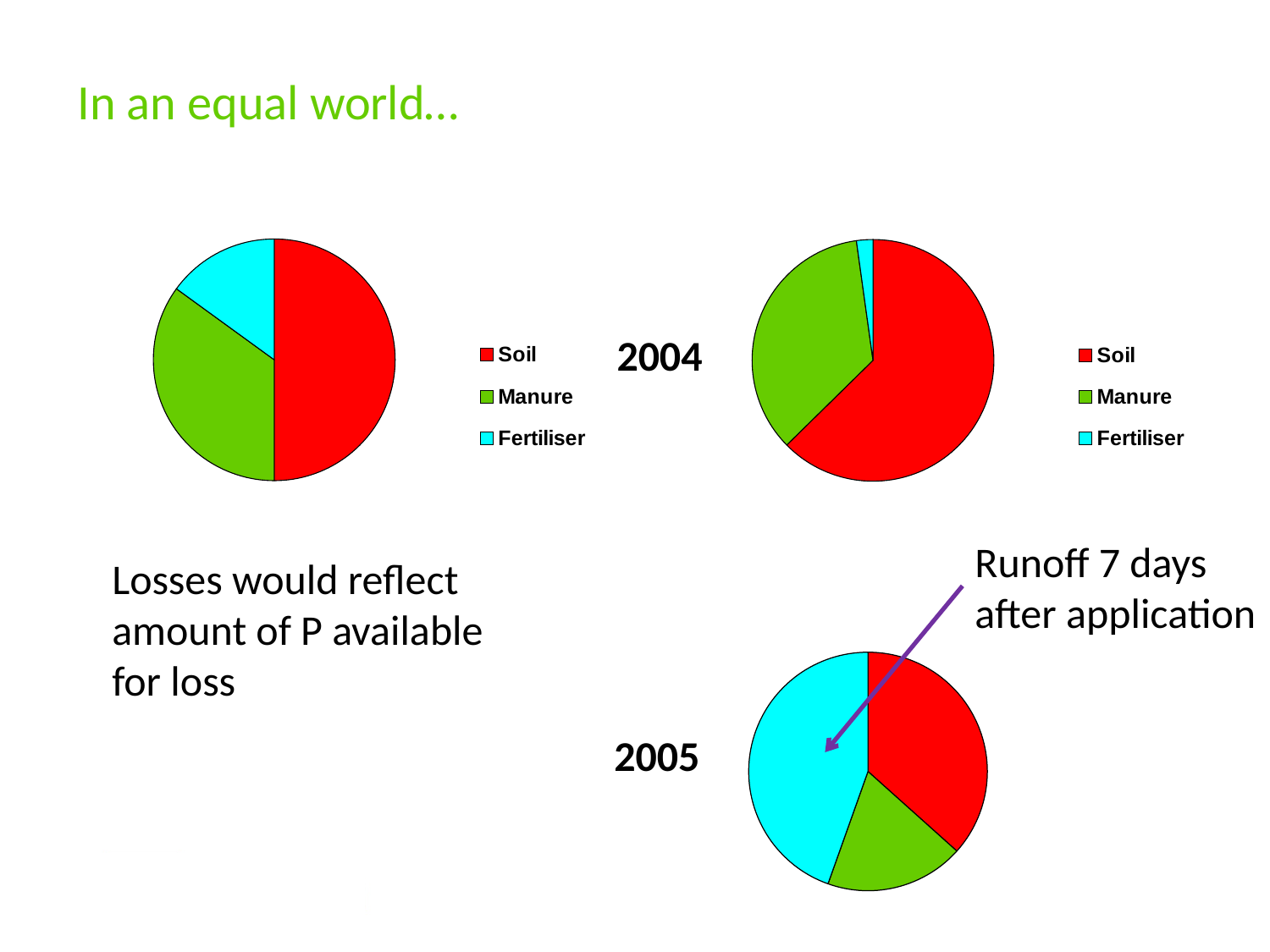
What kind of chart is the 2004 chart on the slide? Pie chart In the 2004 pie chart, which category has the smallest slice? Fertiliser How many categories does the legend next to the 2004 chart list? 3 In the left-hand pie chart (under 'In an equal world...'), which category has the smallest slice? Fertiliser In the 2004 pie chart, which category has the largest slice? Soil What colour represents Fertiliser in the pie charts? Cyan (light blue) In the left-hand pie chart (under 'In an equal world...'), which category has the largest slice? Soil How many charts are shown on the slide? 3 In the 2004 pie chart, which slice is larger: Manure or Fertiliser? Manure